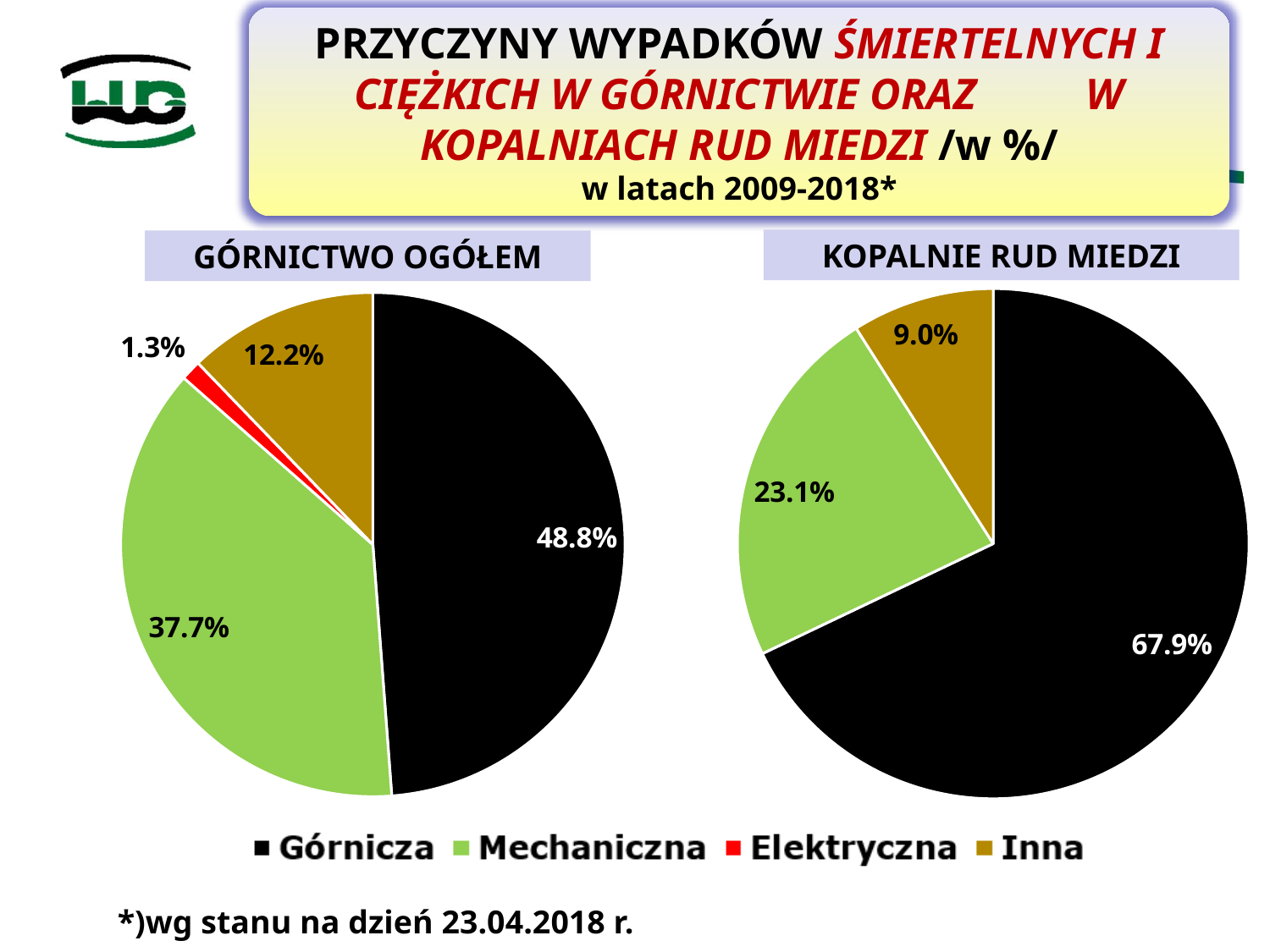
In the GÓRNICTWO OGÓŁEM chart, what share is shown for Mechaniczna? 37.7% In the GÓRNICTWO OGÓŁEM chart, which category has the largest share? Górnicza In the GÓRNICTWO OGÓŁEM chart, which is larger: the share for Inna or the share for Elektryczna? Inna In the GÓRNICTWO OGÓŁEM chart, what share is shown for Elektryczna? 1.3% In the KOPALNIE RUD MIEDZI chart, which labelled category has the smallest share? Inna What kind of charts are shown on the slide? Pie charts In the KOPALNIE RUD MIEDZI chart, what share is shown for Górnicza? 67.9% What is the difference between the Górnicza share in the KOPALNIE RUD MIEDZI chart and the Górnicza share in the GÓRNICTWO OGÓŁEM chart? 19.1 percentage points How many categories does the legend list? 4 In the GÓRNICTWO OGÓŁEM chart, what share is shown for Górnicza? 48.8% In the KOPALNIE RUD MIEDZI chart, what share is shown for Inna? 9.0% In the GÓRNICTWO OGÓŁEM chart, which category has the smallest share? Elektryczna